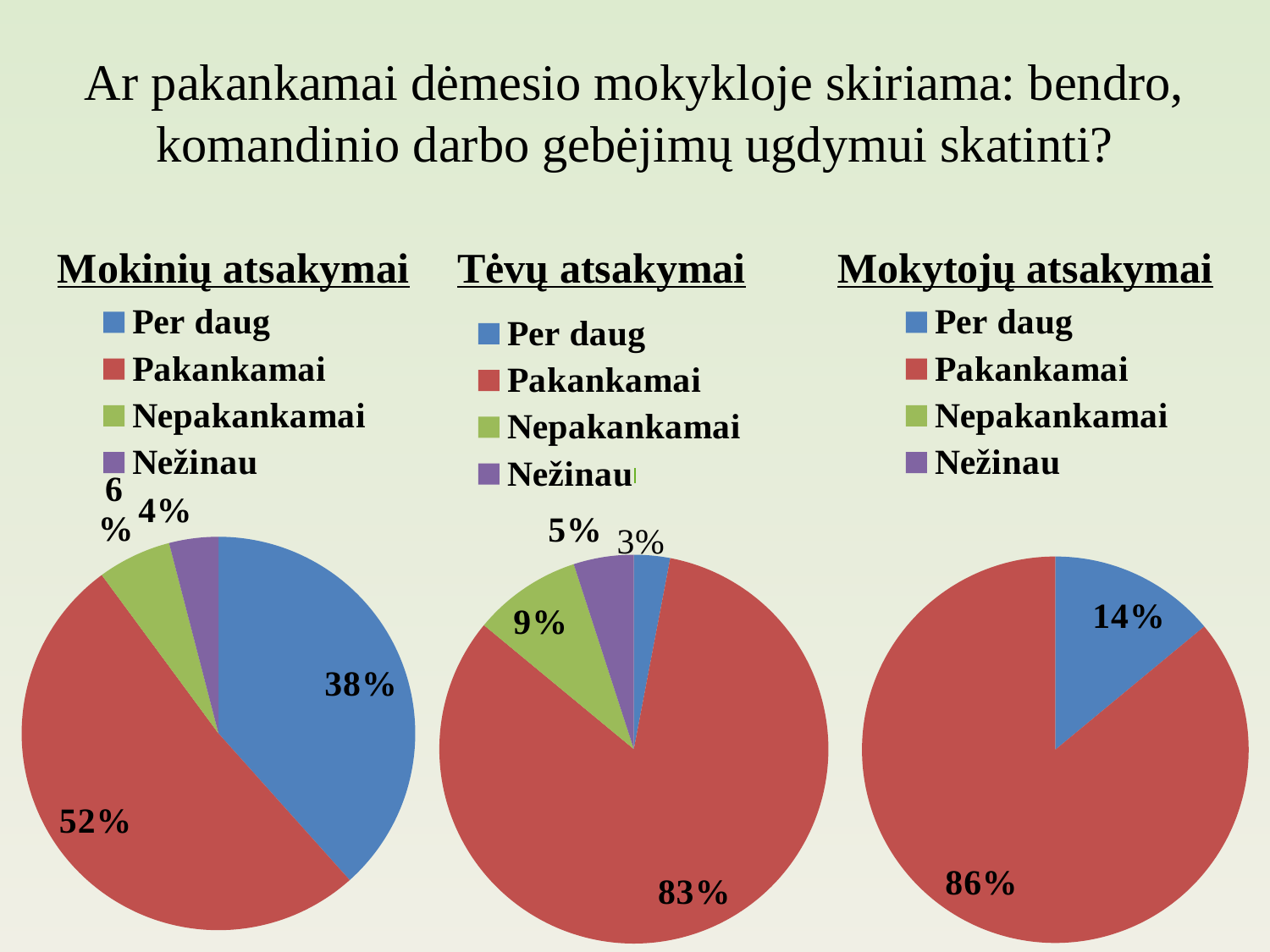
In the 'Mokinių atsakymai' chart, what share of responses is 'Pakankamai'? 52% Which is larger: the 'Per daug' share in the 'Mokinių atsakymai' chart or the 'Per daug' share in the 'Mokytojų atsakymai' chart? Mokinių atsakymai How many slices does the 'Mokytojų atsakymai' pie chart have? 2 In the 'Tėvų atsakymai' chart, which category has the smallest slice? Per daug How many entries does the legend of the 'Tėvų atsakymai' chart list? 4 In the 'Mokytojų atsakymai' chart, what share of responses is 'Pakankamai'? 86% In the 'Tėvų atsakymai' chart, what share of responses is 'Nepakankamai'? 9% In the 'Mokinių atsakymai' chart, what is the difference between the 'Pakankamai' and 'Per daug' shares? 14% What type of chart is used for 'Mokinių atsakymai'? Pie chart In the 'Mokinių atsakymai' chart, what share of responses is 'Per daug'? 38% In the 'Mokytojų atsakymai' chart, which category has the largest slice? Pakankamai In the 'Tėvų atsakymai' chart, what share of responses is 'Per daug'? 3%